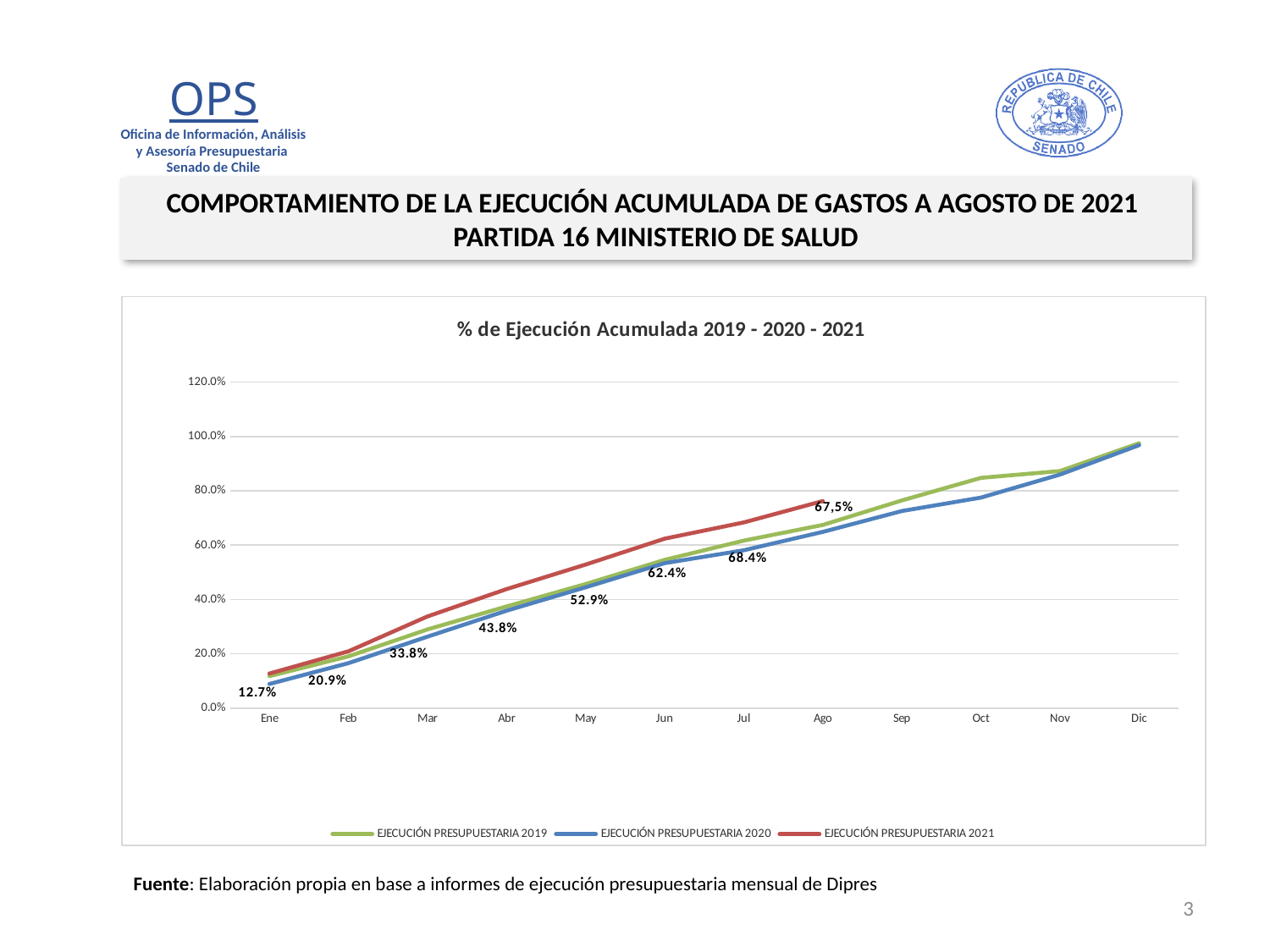
Do the values for EJECUCIÓN PRESUPUESTARIA 2021 rise or fall from Ene to Ago? rise What is the value for EJECUCIÓN PRESUPUESTARIA 2021 in May? 52.9% Is the value for EJECUCIÓN PRESUPUESTARIA 2020 in Dic greater or less than 80.0%? greater What is the value for EJECUCIÓN PRESUPUESTARIA 2021 in Ene? 12.7% How many series does the legend list? 3 What is the title of the chart? % de Ejecución Acumulada 2019 - 2020 - 2021 How many months are shown on the x axis? 12 What is the difference between the EJECUCIÓN PRESUPUESTARIA 2021 values for Jul and Jun? 6.0 percentage points What kind of chart is shown on the slide? line chart What is the value for EJECUCIÓN PRESUPUESTARIA 2021 in Jul? 68.4% In Jul, which series has the higher value, EJECUCIÓN PRESUPUESTARIA 2021 or EJECUCIÓN PRESUPUESTARIA 2020? EJECUCIÓN PRESUPUESTARIA 2021 What is the value for EJECUCIÓN PRESUPUESTARIA 2021 in Mar? 33.8%